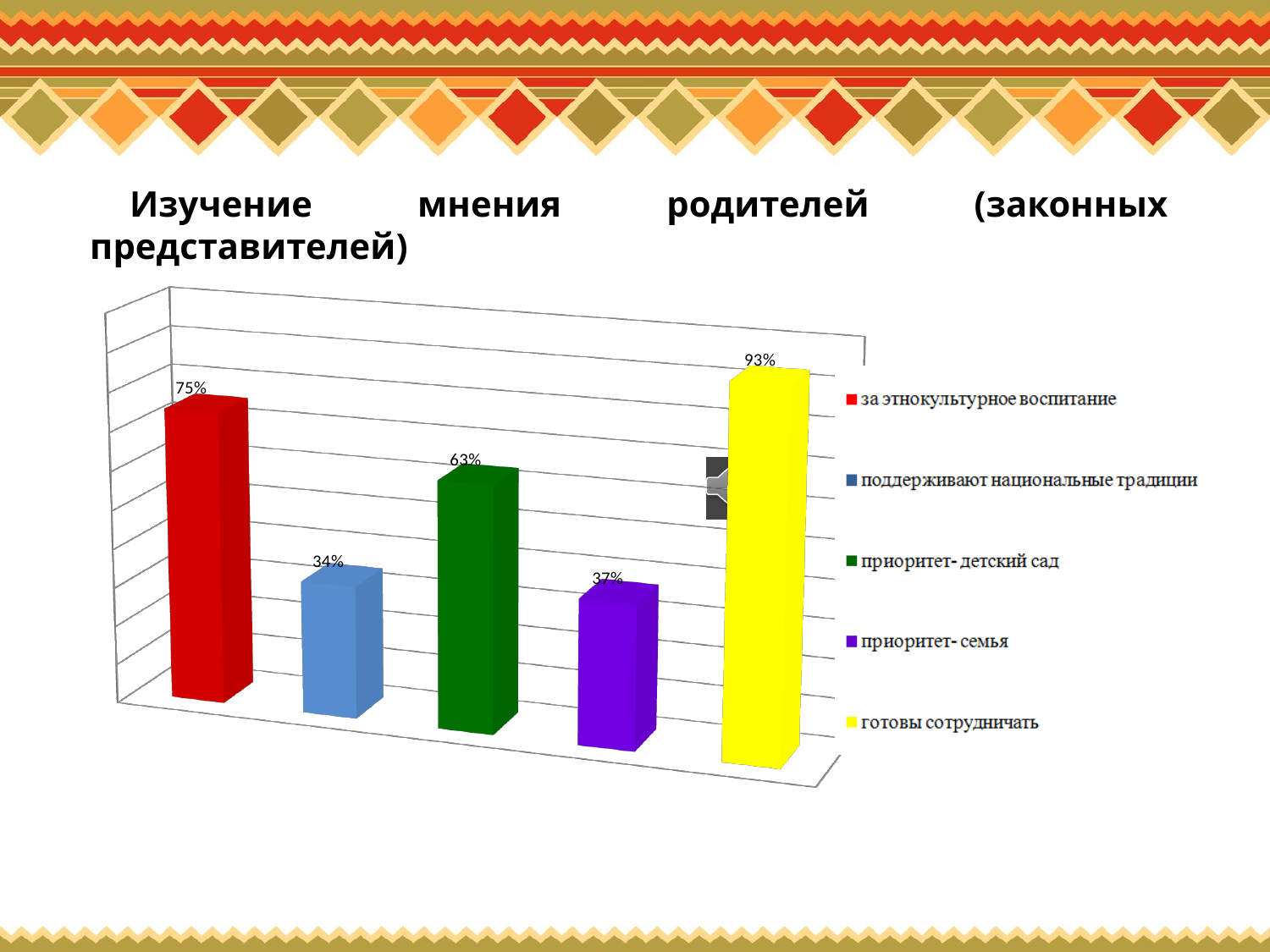
What percentage of parents are ready to cooperate (готовы сотрудничать)? 93% How many bars are plotted in the chart? 5 What kind of chart is shown on the slide? bar chart What percentage of parents are for ethnocultural upbringing (за этнокультурное воспитание)? 75% What is the difference between the values for 'готовы сотрудничать' and 'за этнокультурное воспитание'? 18% What value is shown for 'поддерживают национальные традиции'? 34% What value is shown for 'приоритет- семья'? 37% Which category has the highest value? готовы сотрудничать Which category has the lowest value? поддерживают национальные традиции How many entries does the legend list? 5 Which is larger: the value for 'приоритет- детский сад' or for 'приоритет- семья'? приоритет- детский сад What value is shown for 'приоритет- детский сад'? 63%